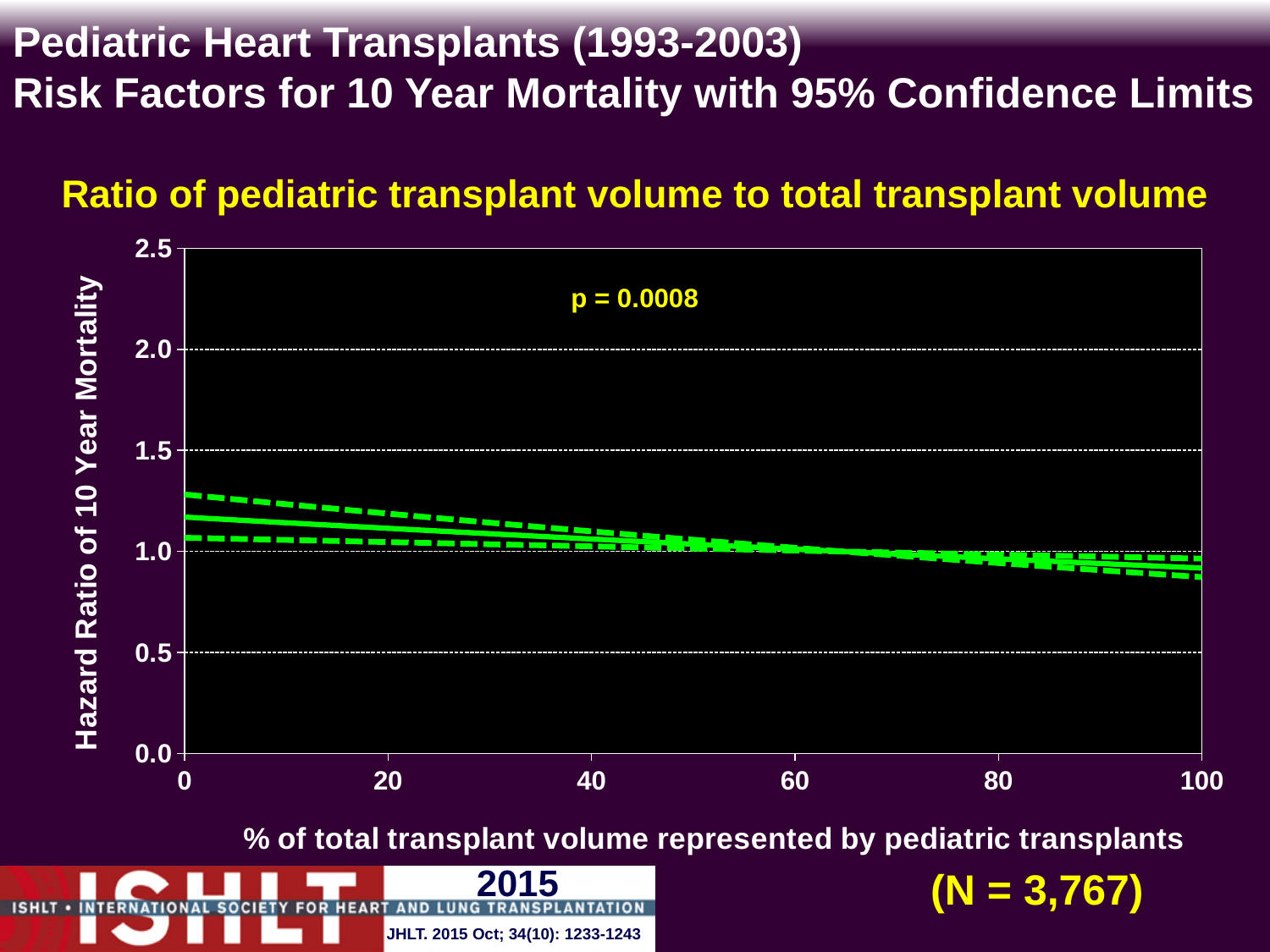
What is the sample size (N) shown on the slide? N = 3,767 What is the p-value shown on the chart? p = 0.0008 Is the hazard ratio (solid line) at 20% of total transplant volume greater or less than 1.0? greater What is the maximum value shown on the y-axis of the chart? 2.5 What is the maximum value shown on the x-axis of the chart? 100 Is the hazard ratio (solid line) at 0% of total transplant volume greater or less than 1.0? greater Is the hazard ratio (solid line) at 100% of total transplant volume greater or less than 1.0? less Does the hazard ratio of 10 year mortality rise or fall as the % of total transplant volume represented by pediatric transplants increases? fall How many lines are plotted on the chart (the estimate plus its confidence limits)? 3 What kind of chart is shown on the slide? line chart